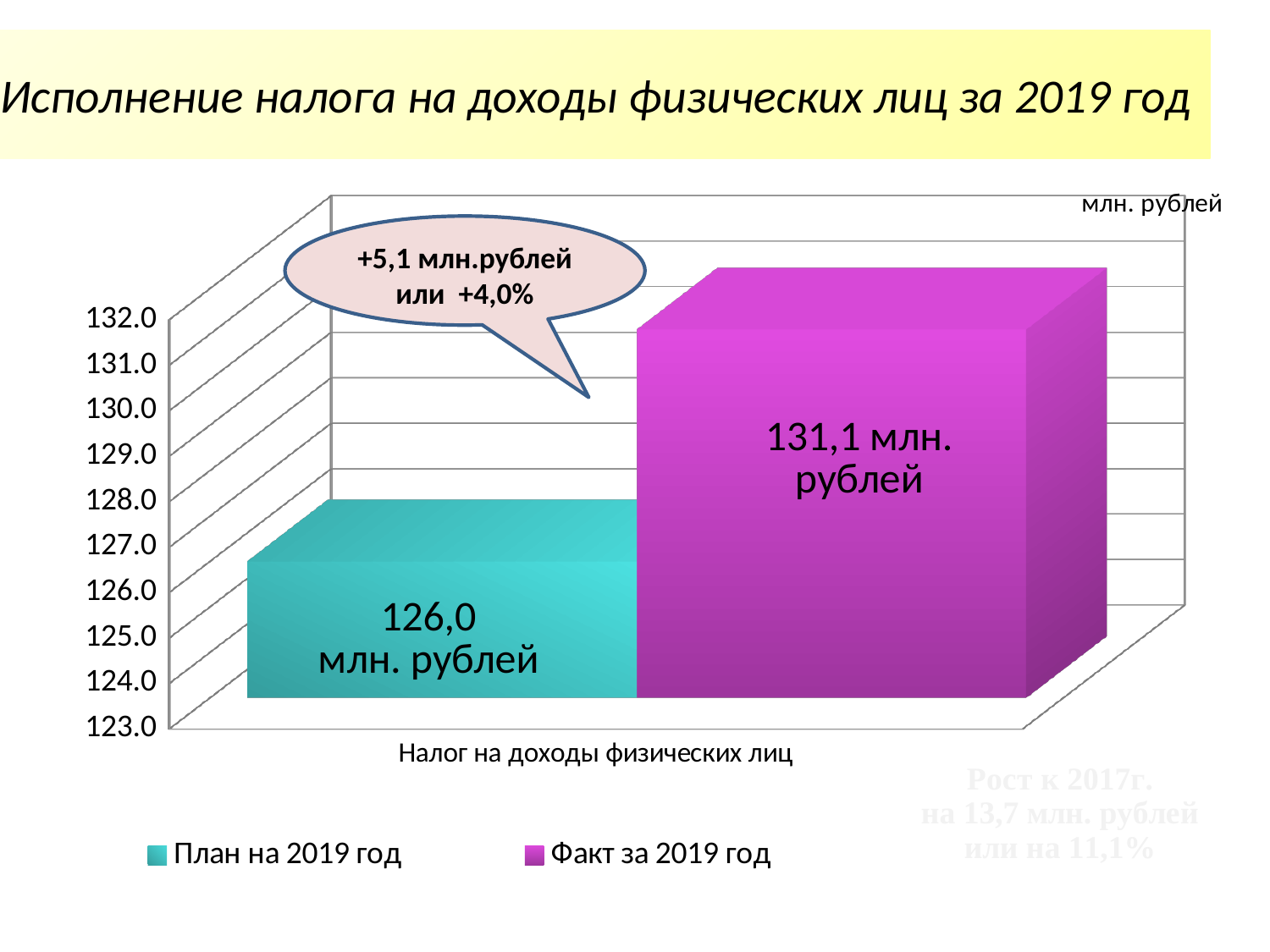
What is the category label shown on the x axis of the chart? Налог на доходы физических лиц What percentage increase does the callout on the chart state? +4,0% What kind of chart is shown on the slide? Bar chart Is the value for 'План на 2019 год' greater or less than 128.0? less Which series has the higher value, 'План на 2019 год' or 'Факт за 2019 год'? Факт за 2019 год What is the value for the series 'Факт за 2019 год'? 131,1 млн. рублей Which series has the lowest value on the chart? План на 2019 год What is the difference between the 'Факт за 2019 год' value and the 'План на 2019 год' value? 5,1 млн. рублей Which series has the highest value on the chart? Факт за 2019 год How many series does the legend list? 2 What is the value for the series 'План на 2019 год'? 126,0 млн. рублей Is the value for 'Факт за 2019 год' greater or less than 130.0? greater